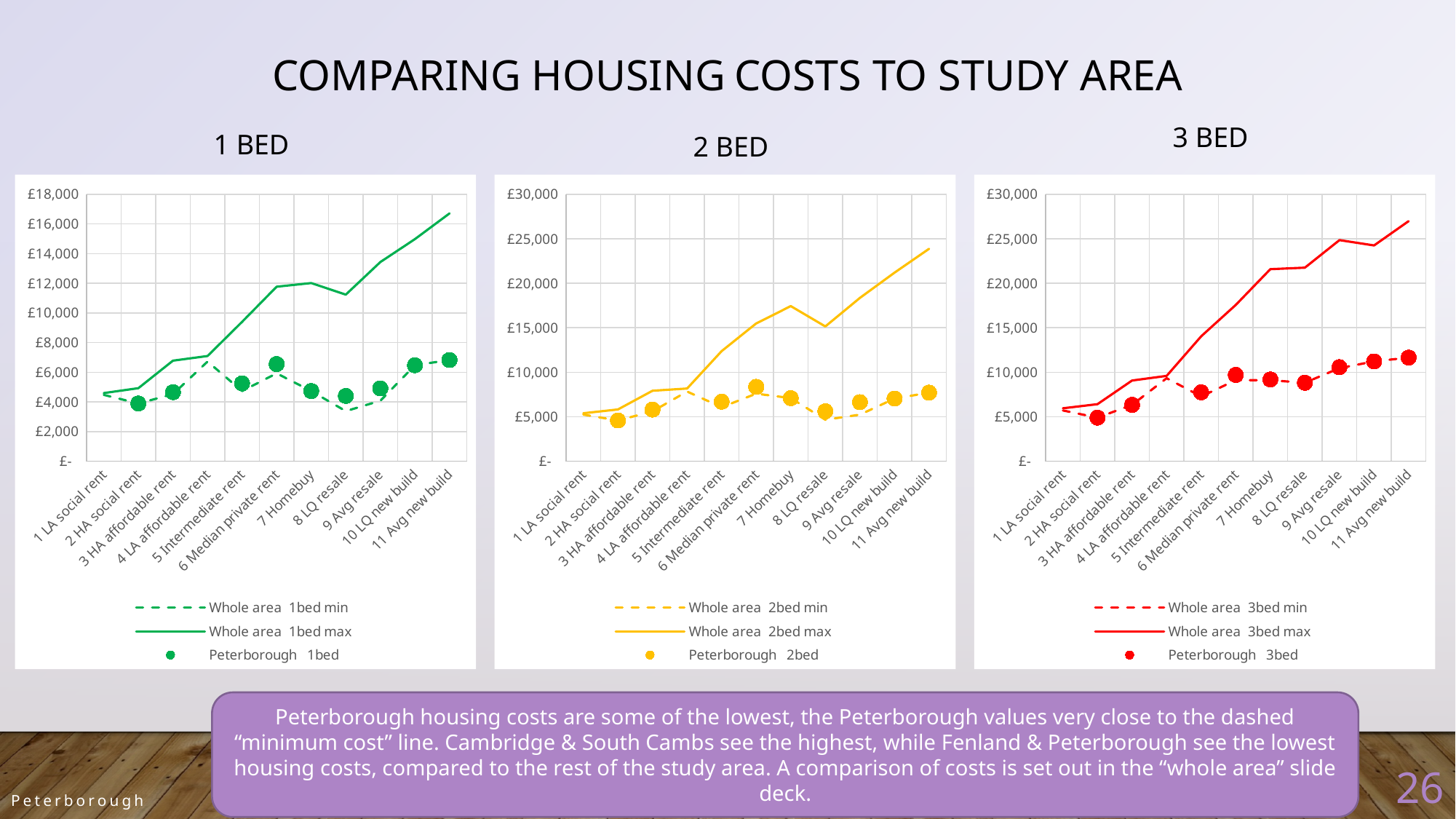
In the 1 BED chart, which category has the lowest Peterborough 1bed value? 2 HA social rent In the 1 BED chart, is the Whole area 1bed max value for 11 Avg new build greater or less than £14,000? greater In the 2 BED chart, is the Whole area 2bed max value for 11 Avg new build greater or less than £20,000? greater What kind of chart is the 1 BED chart? line chart How many series does the legend of the 3 BED chart list? 3 In the 3 BED chart, is the Peterborough 3bed value for 11 Avg new build greater or less than £10,000? greater In the 2 BED chart, which is larger for Whole area 2bed max: 7 Homebuy or 8 LQ resale? 7 Homebuy In the 3 BED chart, does the Whole area 3bed max line generally rise or fall from left to right? rise How many categories are shown on the x axis of the 2 BED chart? 11 What colour are the Peterborough 3bed markers in the 3 BED chart? red In the 1 BED chart, which category has the highest value for Whole area 1bed max? 11 Avg new build